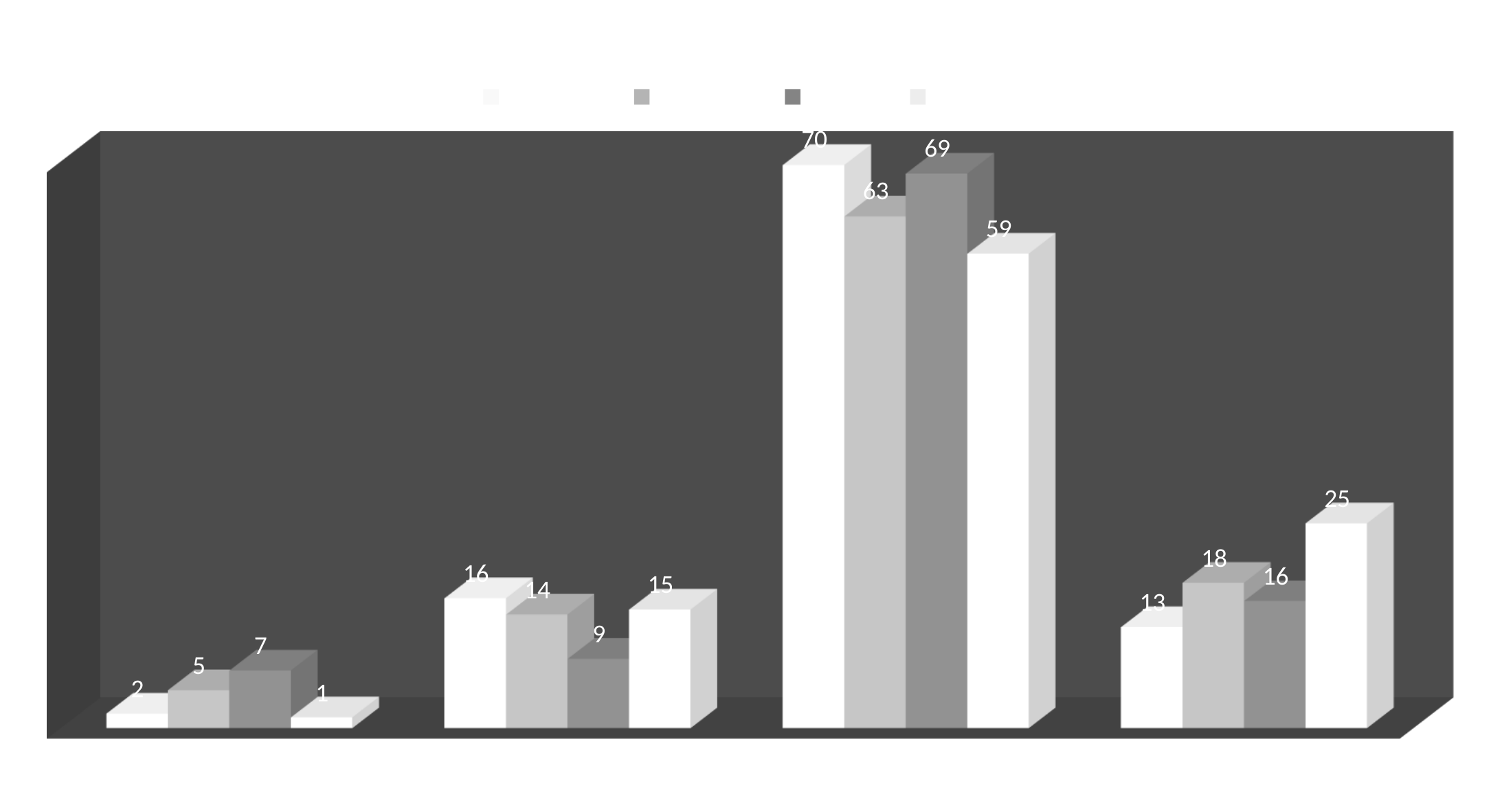
What is the highest data label shown on the chart? 70 In the second group from the left, which is larger: the first bar or the third bar? the first bar What kind of chart is shown on the slide? bar chart What is the value of the rightmost bar in the fourth group from the left? 25 What is the value of the second bar in the second group from the left? 14 What is the lowest data label shown on the chart? 1 How many groups of bars are plotted along the x axis? 4 What is the value of the first (leftmost) bar in the third group from the left? 70 In the third group from the left, what is the difference between the first bar (70) and the fourth bar (59)? 11 How many bars are plotted in total on the chart? 16 How many series does the legend list? 4 In the fourth group from the left, what is the difference between the fourth bar (25) and the first bar (13)? 12